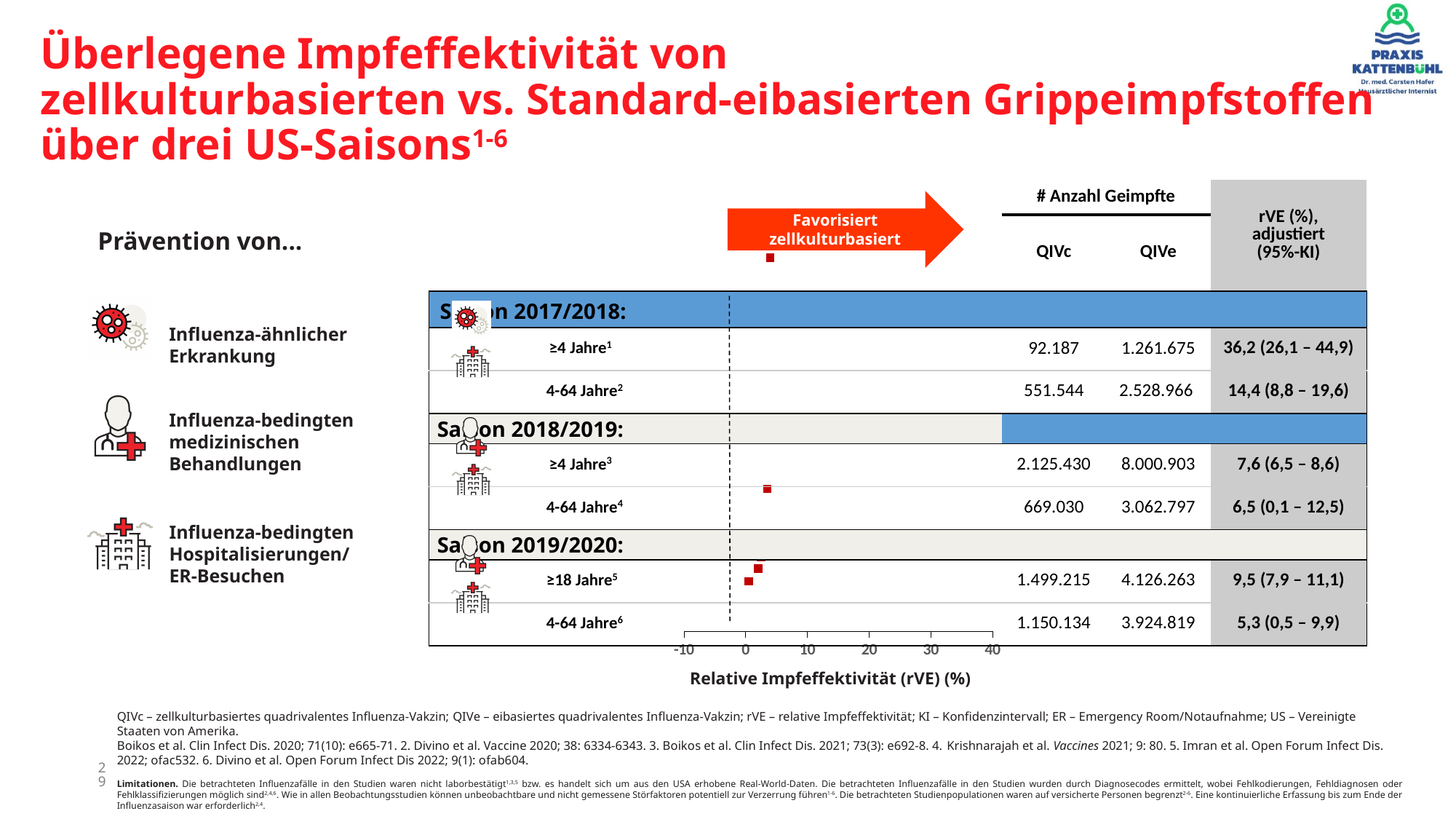
Which group and season has the highest adjusted rVE point estimate? ≥4 Jahre, Saison 2017/2018 Which group and season has the lowest adjusted rVE point estimate? 4-64 Jahre, Saison 2019/2020 How many QIVc recipients are listed for the ≥18 Jahre group in Saison 2019/2020? 1.499.215 Is the rVE point estimate for the ≥4 Jahre group in Saison 2017/2018 greater or less than 30? greater What is the highest tick value shown on the x axis? 40 What is the adjusted rVE (%) for the 4-64 Jahre group in Saison 2018/2019? 6,5 (0,1 – 12,5) How many age-group rows (data points) are shown across the three seasons? 6 What is the adjusted rVE (%) for the ≥4 Jahre group in Saison 2017/2018? 36,2 (26,1 – 44,9) What is the difference between the rVE point estimates of the ≥4 Jahre and 4-64 Jahre groups in Saison 2017/2018? 21,8 What is the label of the x axis of the chart? Relative Impfeffektivität (rVE) (%) How many QIVe recipients are listed for the ≥4 Jahre group in Saison 2018/2019? 8.000.903 Which has the larger rVE point estimate: ≥18 Jahre in Saison 2019/2020 or ≥4 Jahre in Saison 2018/2019? ≥18 Jahre in Saison 2019/2020